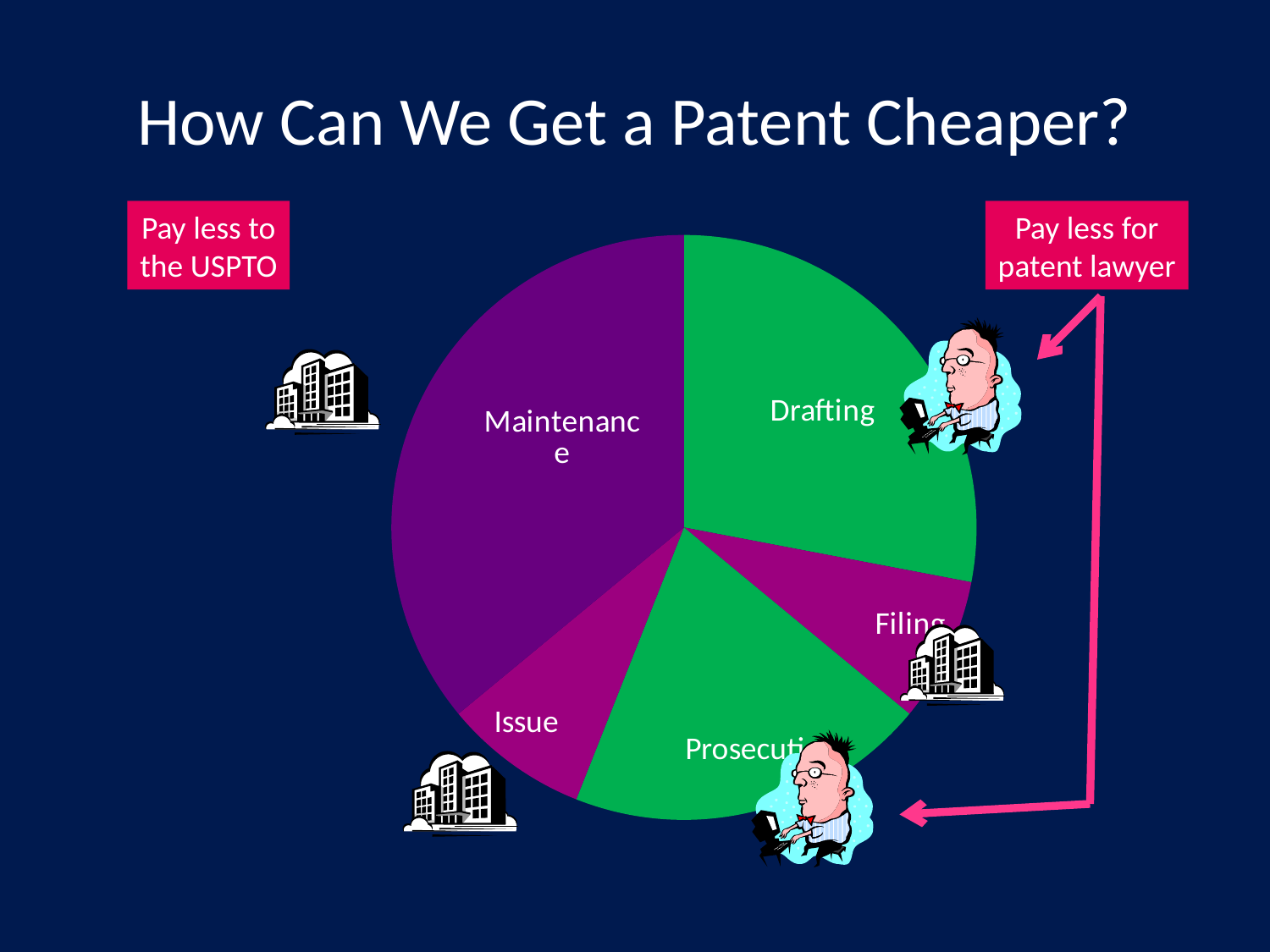
Which slice is larger, Drafting or Prosecution? Drafting What colour are the Drafting and Prosecution slices of the pie chart? Green What is the title of the slide containing the pie chart? How Can We Get a Patent Cheaper? Which slice of the pie chart is the largest? Maintenance How many slices does the pie chart have? 5 Which slice is larger, Drafting or Filing? Drafting What kind of chart is shown on the slide? Pie chart Which slice is larger, Prosecution or Issue? Prosecution